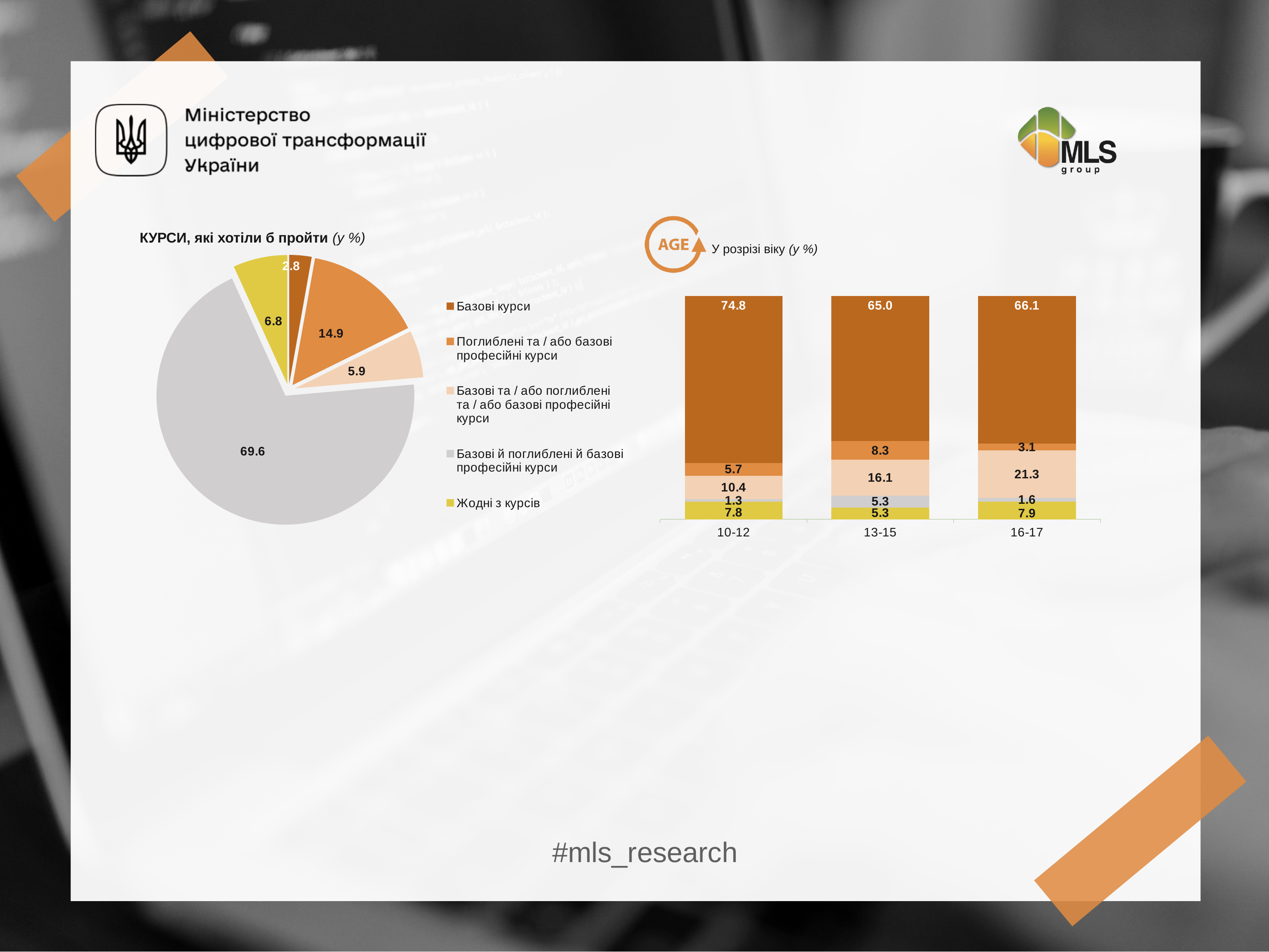
In the pie chart 'КУРСИ, які хотіли б пройти', what is the value for 'Жодні з курсів'? 6.8 In the chart 'У розрізі віку', what is the value of the top (dark orange) segment for the 10-12 age group? 74.8 In the pie chart 'КУРСИ, які хотіли б пройти', which category has the largest slice? Базові й поглиблені й базові професійні курси In the pie chart 'КУРСИ, які хотіли б пройти', which category has the smallest slice? Базові курси In the chart 'У розрізі віку', which age group has the highest value for the top (dark orange) segment? 10-12 How many slices does the pie chart 'КУРСИ, які хотіли б пройти' have? 5 What kind of chart is the chart titled 'КУРСИ, які хотіли б пройти'? pie chart How many age groups are shown on the x axis of the chart 'У розрізі віку'? 3 In the pie chart 'КУРСИ, які хотіли б пройти', what is the difference between the values for 'Поглиблені та / або базові професійні курси' and 'Базові та / або поглиблені та / або базові професійні курси'? 9.0 In the chart 'У розрізі віку', what is the total of the stacked bar for the 13-15 age group? 100.0 In the chart 'У розрізі віку', what is the value of the bottom (yellow) segment for the 16-17 age group? 7.9 What kind of chart is the chart titled 'У розрізі віку' on the right of the slide? stacked bar chart